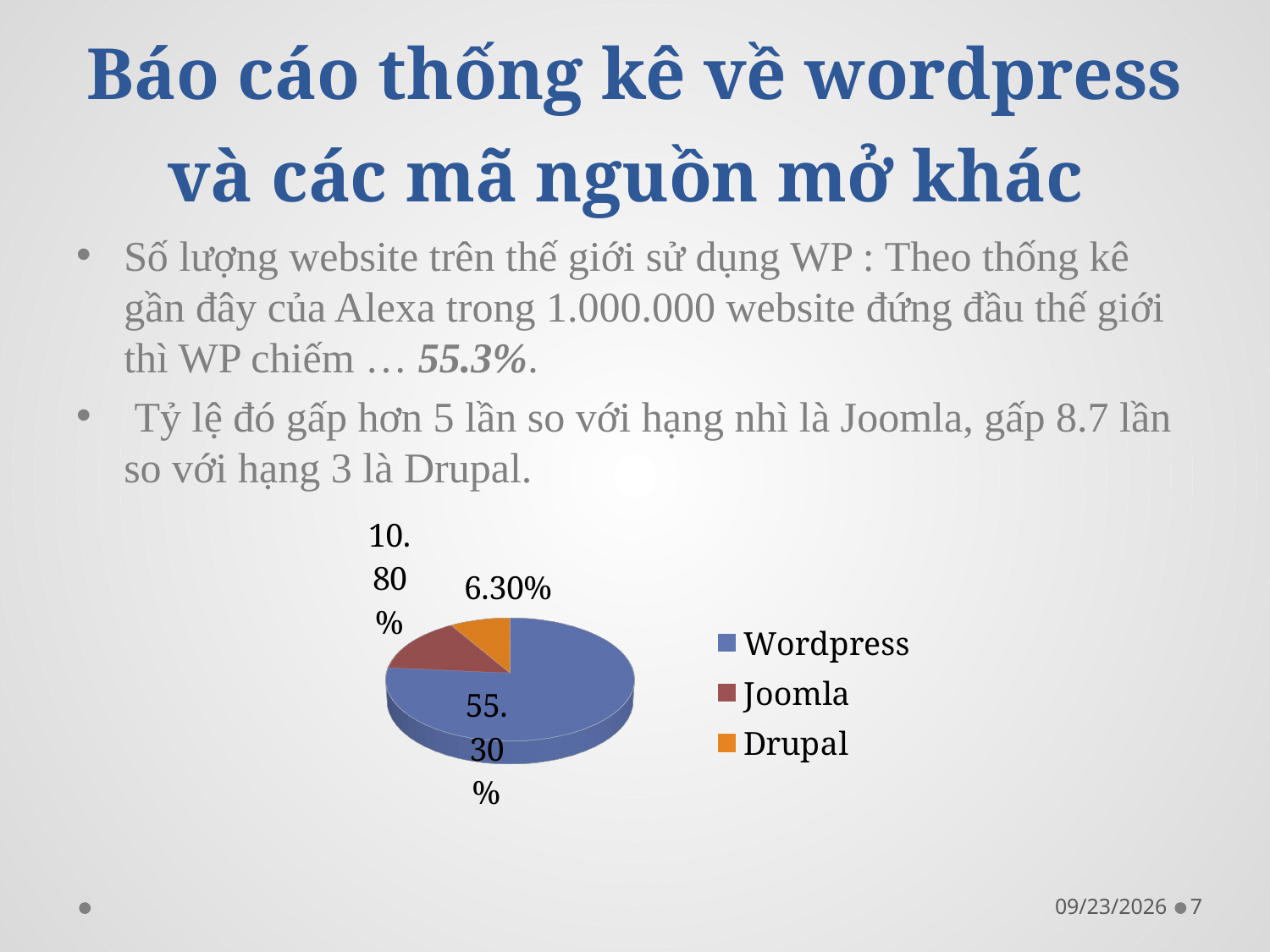
What is the value shown for Drupal in the pie chart? 6.30% How many entries does the legend of the pie chart list? 3 What is the difference between the Wordpress value and the Joomla value in the pie chart? 44.50% What is the difference between the Joomla value and the Drupal value in the pie chart? 4.50% How many categories does the pie chart show? 3 What kind of chart is shown on the slide? pie chart What is the value shown for Wordpress in the pie chart? 55.30% What colour is the Drupal slice in the pie chart? orange What is the value shown for Joomla in the pie chart? 10.80% Which is larger in the pie chart, the Joomla slice or the Drupal slice? Joomla Which category has the largest slice in the pie chart? Wordpress Which category has the smallest slice in the pie chart? Drupal